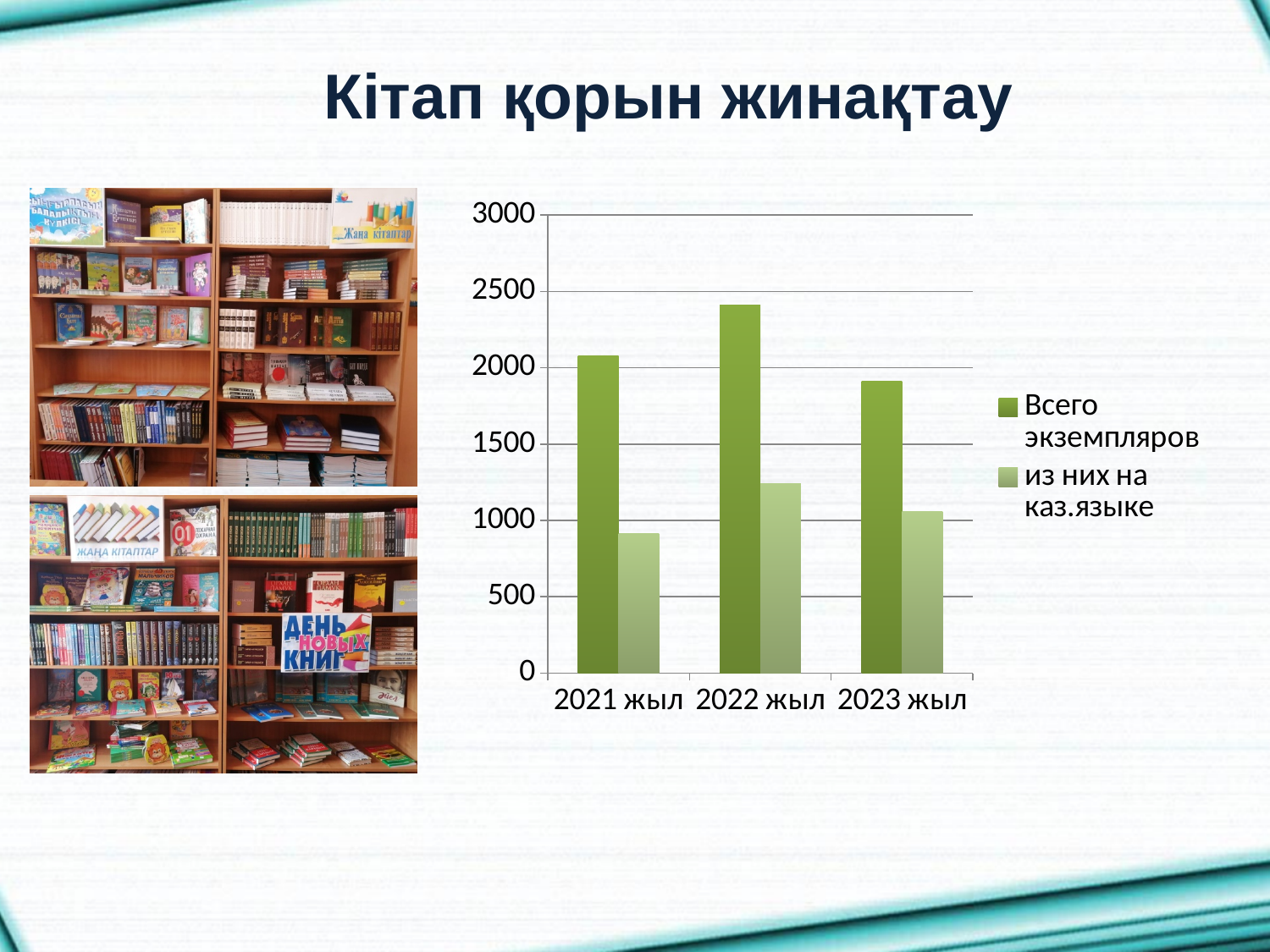
How many years are shown on the x axis? 3 Is the value for "Всего экземпляров" in 2022 жыл greater or less than 2000? greater How many series does the legend list? 2 Which is larger: "Всего экземпляров" in 2021 жыл or "Всего экземпляров" in 2023 жыл? 2021 жыл Is the value for "Всего экземпляров" in 2023 жыл greater or less than 2000? less Is the value for "из них на каз.языке" in 2021 жыл greater or less than 1000? less Which year has the lowest value for "из них на каз.языке"? 2021 жыл Which year has the lowest value for "Всего экземпляров"? 2023 жыл What kind of chart is shown on the slide? bar chart Which year has the highest value for "Всего экземпляров"? 2022 жыл Which year has the highest value for "из них на каз.языке"? 2022 жыл What is the title of the slide containing the chart? Кітап қорын жинақтау